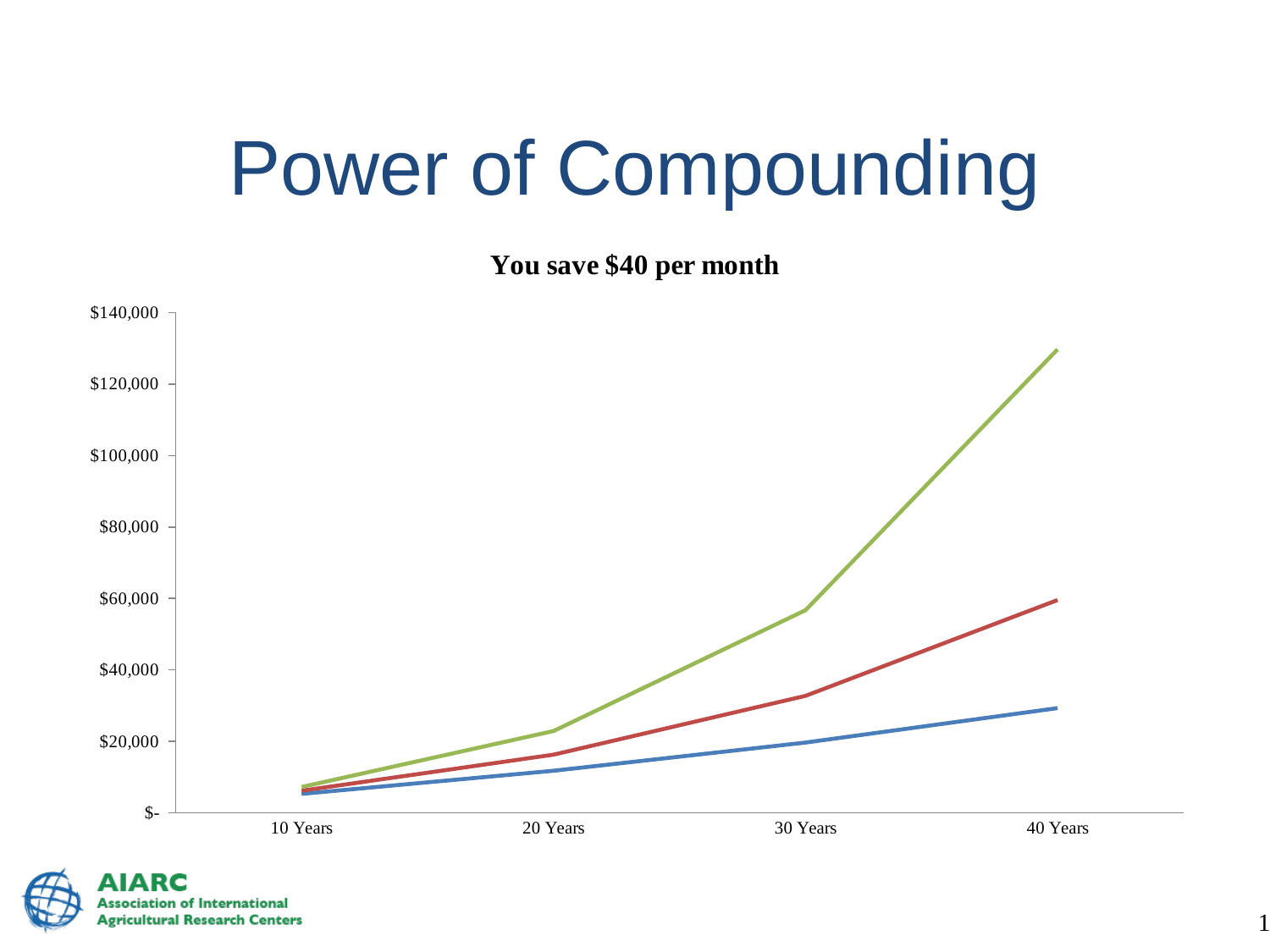
Is the value of the blue line at 30 Years greater or less than $40,000? less How many lines are plotted on the chart? 3 Is the value of the green line at 20 Years greater or less than $40,000? less Is the value of the green line at 40 Years greater or less than $120,000? greater Which line has the highest value at 40 Years? the green line What kind of chart is shown on the slide? line chart What is the title of the chart? You save $40 per month Do the values of the green line rise or fall from 10 Years to 40 Years? rise Which line has the lowest value at 40 Years? the blue line At 40 Years, which is larger: the value of the red line or the value of the blue line? the red line How many points are on the x axis of the chart? 4